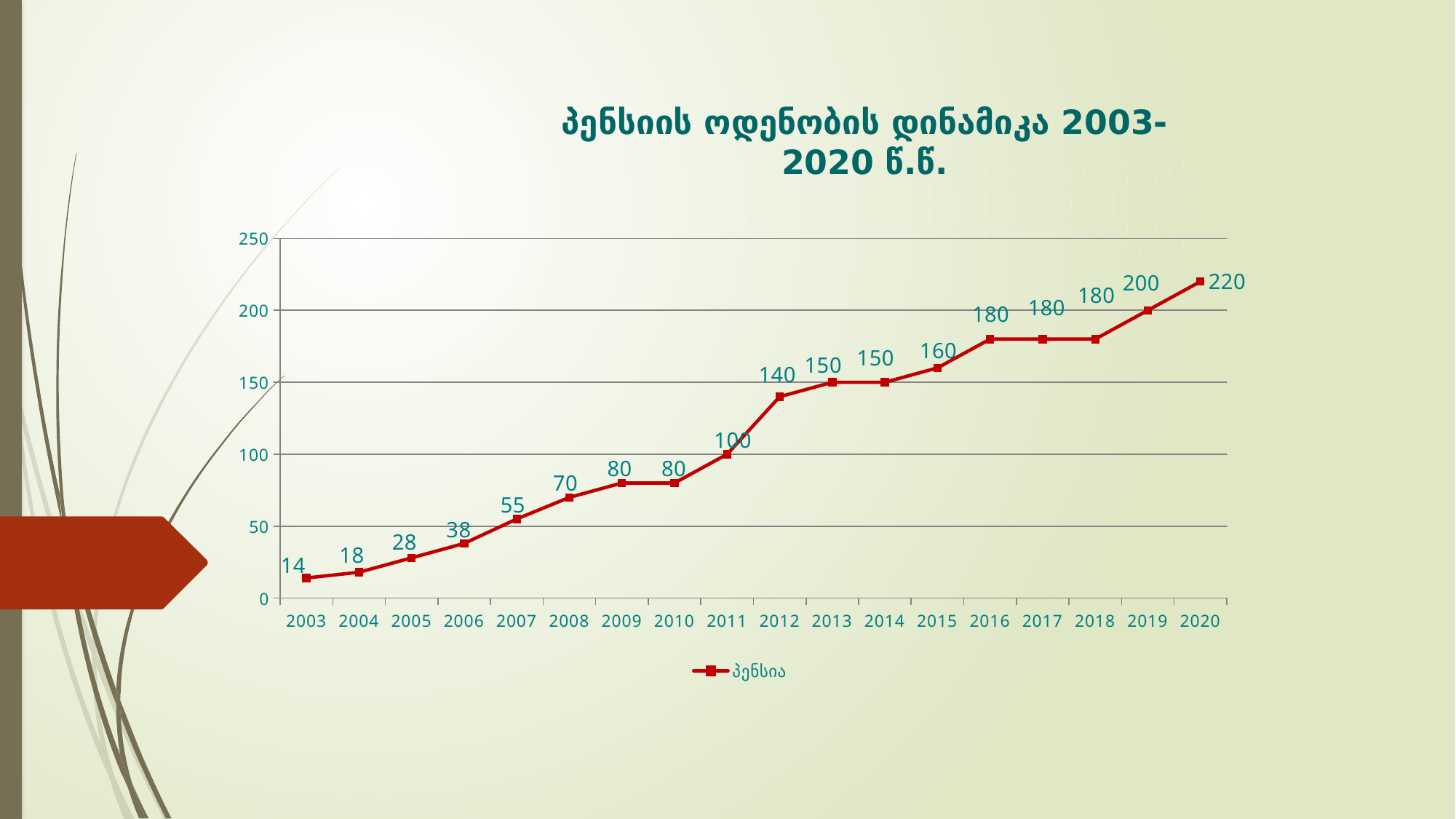
What is the value for 2003? 14 How many years are plotted on the x axis? 18 What is the value for 2007? 55 Which year has the highest value? 2020 What is the value for 2012? 140 Which is larger, the value for 2015 or the value for 2014? 2015 Which year has the lowest value? 2003 What is the difference between the values for 2011 and 2006? 62 What kind of chart is shown? line chart How many series does the legend list? 1 What is the difference between the values for 2020 and 2019? 20 Do the values generally rise or fall from 2003 to 2020? rise